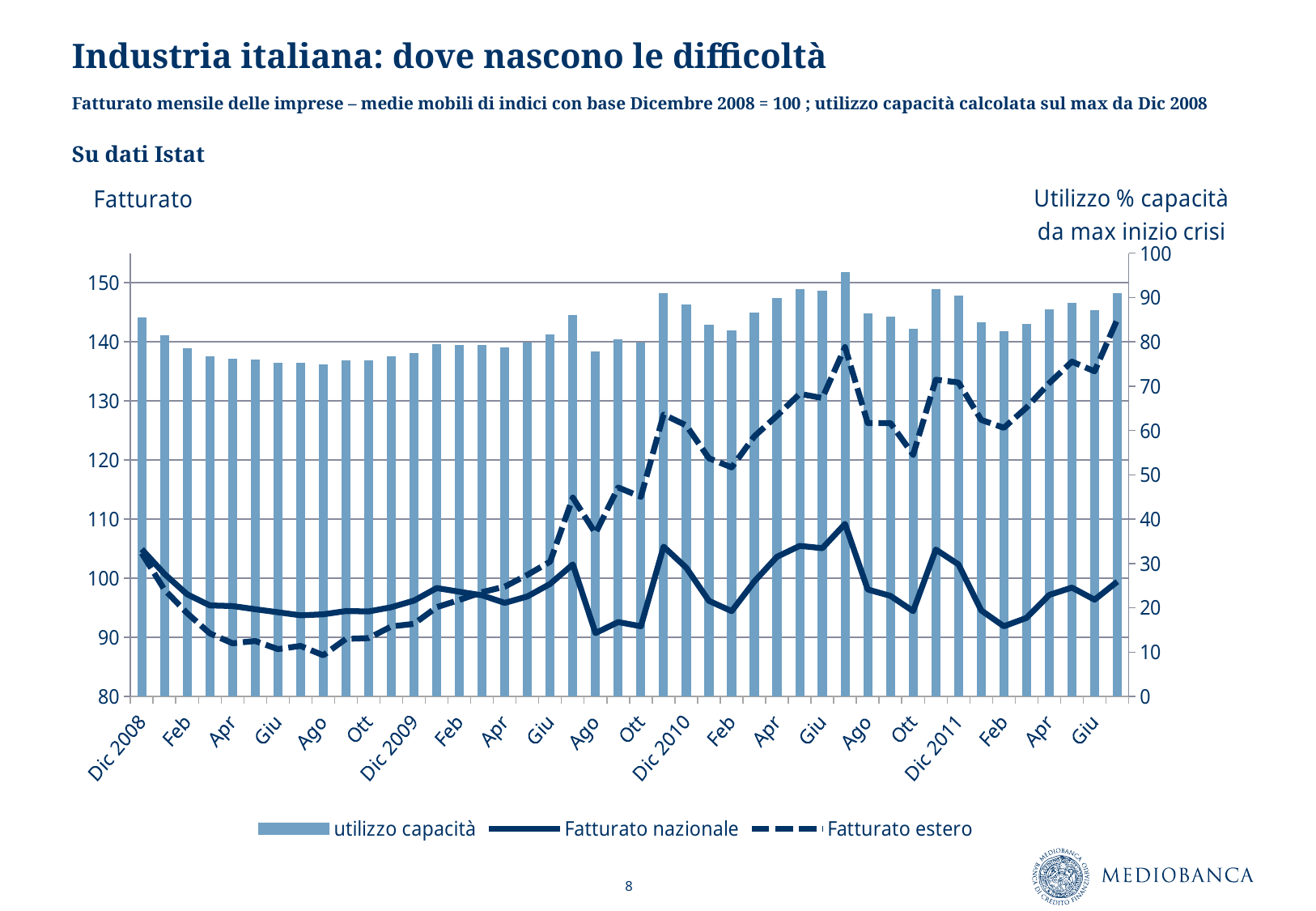
How many series does the legend list? 3 Is the value of Fatturato nazionale in Ago 2009 greater or less than 100? less In Dic 2010, which is higher, Fatturato nazionale or Fatturato estero? Fatturato estero Which series is drawn as a dashed line? Fatturato estero What kind of chart is shown on the slide? A combination bar and line chart Is the value of Fatturato estero in Dic 2010 greater or less than 120? greater Is the value of Fatturato estero at the last point on the chart greater or less than 130? greater What is the title of the right-hand axis? Utilizzo % capacità da max inizio crisi Does Fatturato nazionale rise or fall from Dic 2008 to Ago 2009? fall In which month does Fatturato estero reach its lowest value? Ago 2009 Does Fatturato estero rise or fall overall from Dic 2008 to the end of the chart? rise